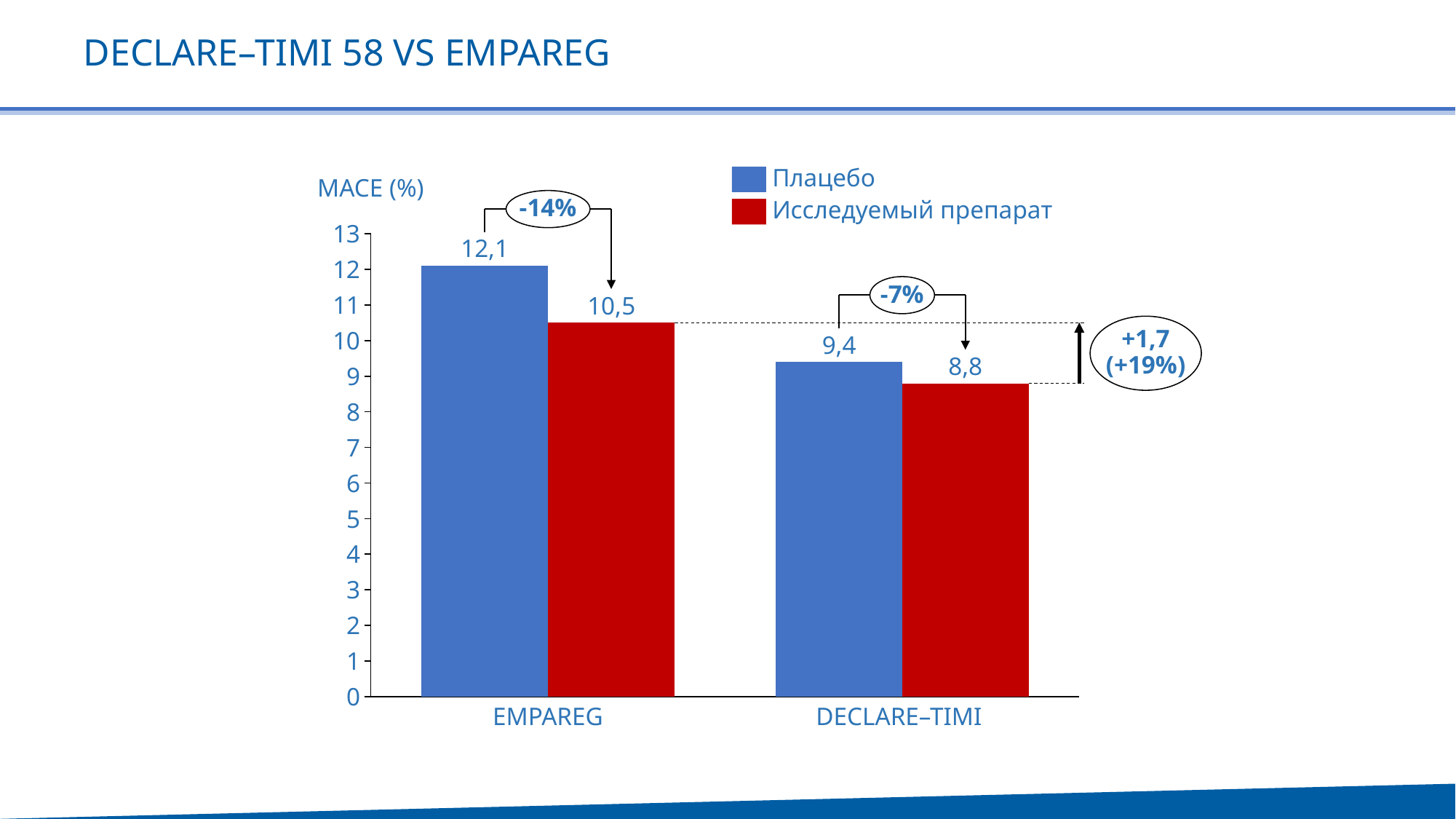
Which bar has the lowest MACE (%) value on the chart? Исследуемый препарат in DECLARE–TIMI What is the MACE (%) value for Плацебо in the EMPAREG trial? 12,1 What kind of chart is shown on the slide? Bar chart How many series does the legend list? 2 How many trials (categories) are shown on the x axis? 2 What is the difference between the Плацебо and Исследуемый препарат values in the EMPAREG trial? 1,6 What is the MACE (%) value for Исследуемый препарат in the DECLARE–TIMI trial? 8,8 What is the MACE (%) value for Плацебо in the DECLARE–TIMI trial? 9,4 Which bar has the highest MACE (%) value on the chart? Плацебо in EMPAREG What percentage reduction is annotated above the EMPAREG bars? -14% Which is larger: the Плацебо value for EMPAREG or the Плацебо value for DECLARE–TIMI? EMPAREG What is the MACE (%) value for Исследуемый препарат in the EMPAREG trial? 10,5